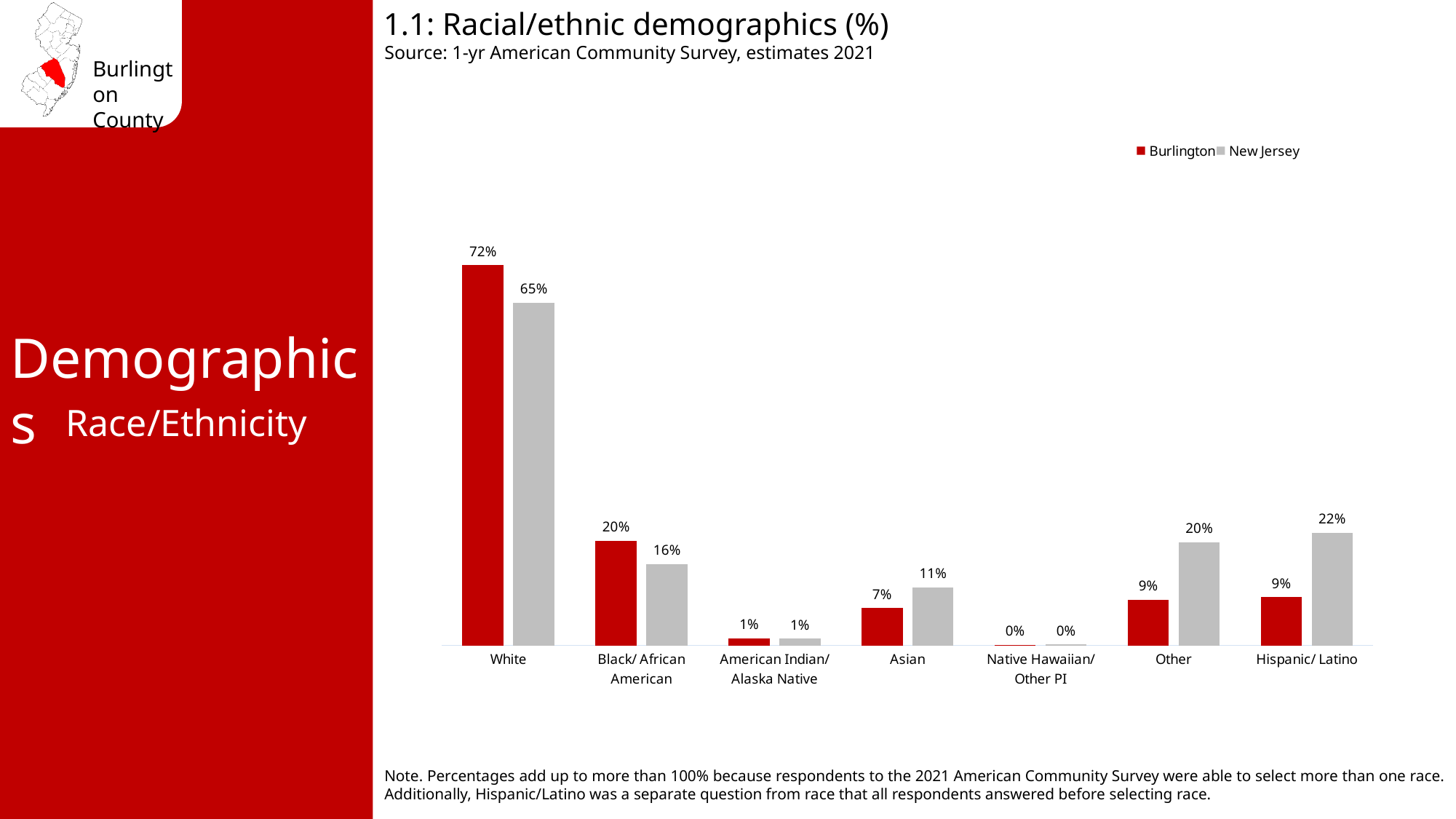
What is the New Jersey value for Hispanic/ Latino? 22% What is the difference between the New Jersey and Burlington values for Hispanic/ Latino? 13% What is the difference between the Burlington and New Jersey values for White? 7% Which category has the highest Burlington value? White What is the Burlington value for White? 72% How many series does the legend list? 2 Which category has the highest New Jersey value? White How many racial/ethnic categories are shown on the x axis? 7 What is the Burlington value for Asian? 7% Which is larger for Other: Burlington or New Jersey? New Jersey What type of chart is shown? Bar chart Which is larger for Black/ African American: Burlington or New Jersey? Burlington